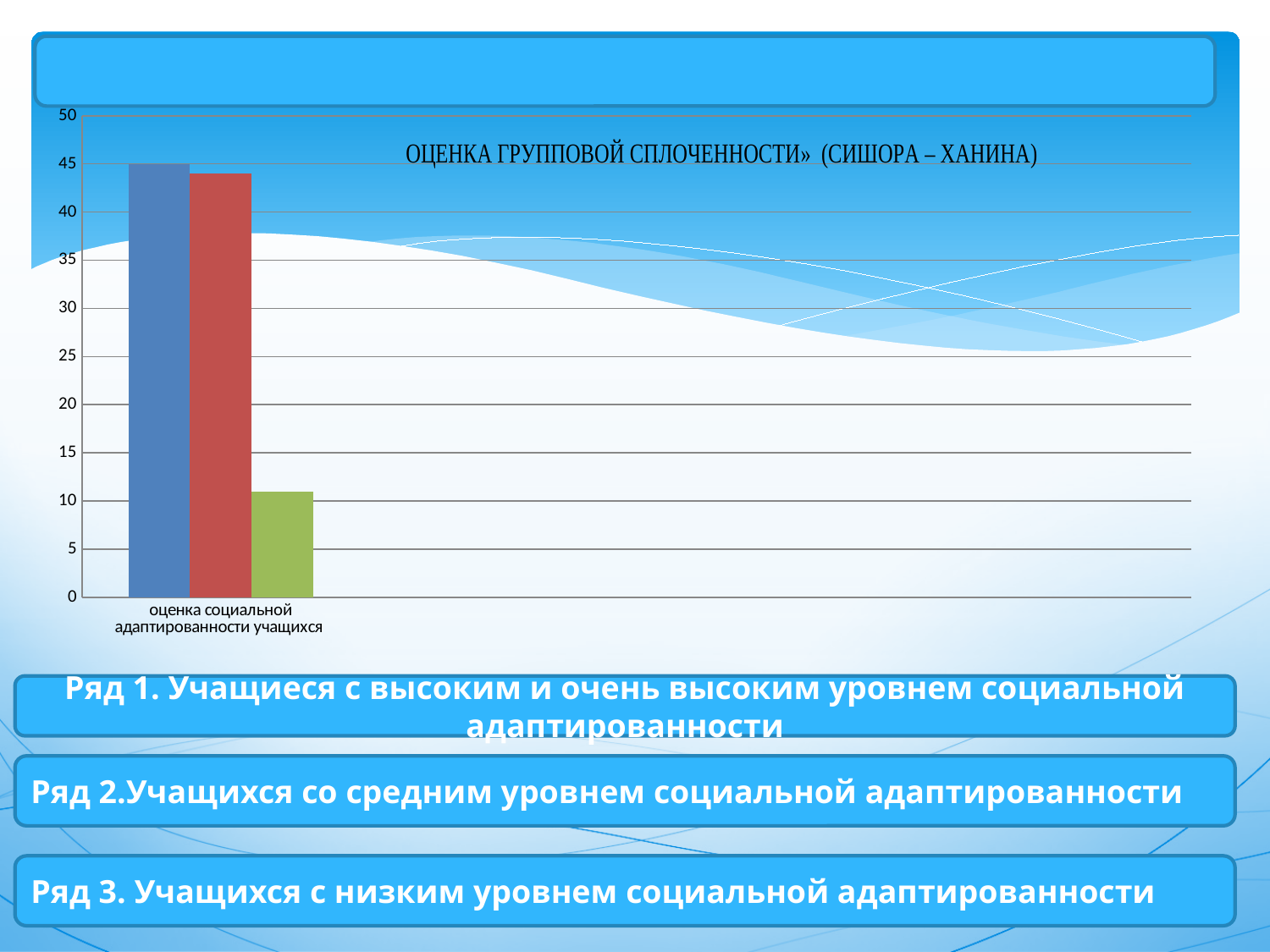
What is the label of the category on the x axis? оценка социальной адаптированности учащихся What kind of chart is shown on the slide? bar chart Is the value of the blue bar (Ряд 1) greater or less than 40? greater Which is larger, the blue bar (Ряд 1) or the green bar (Ряд 3)? the blue bar (Ряд 1) What is the maximum value shown on the y axis of the chart? 50 Is the value of the red bar (Ряд 2) greater or less than 40? greater How many categories are shown on the x axis of the chart? 1 How many bars are plotted in the chart? 3 Which is larger, the red bar (Ряд 2) or the green bar (Ряд 3)? the red bar (Ряд 2) Which bar is the lowest in the chart? the green bar (Ряд 3) What is the title of the chart? ОЦЕНКА ГРУППОВОЙ СПЛОЧЕННОСТИ» (СИШОРА – ХАНИНА) Is the value of the green bar (Ряд 3) greater or less than 15? less